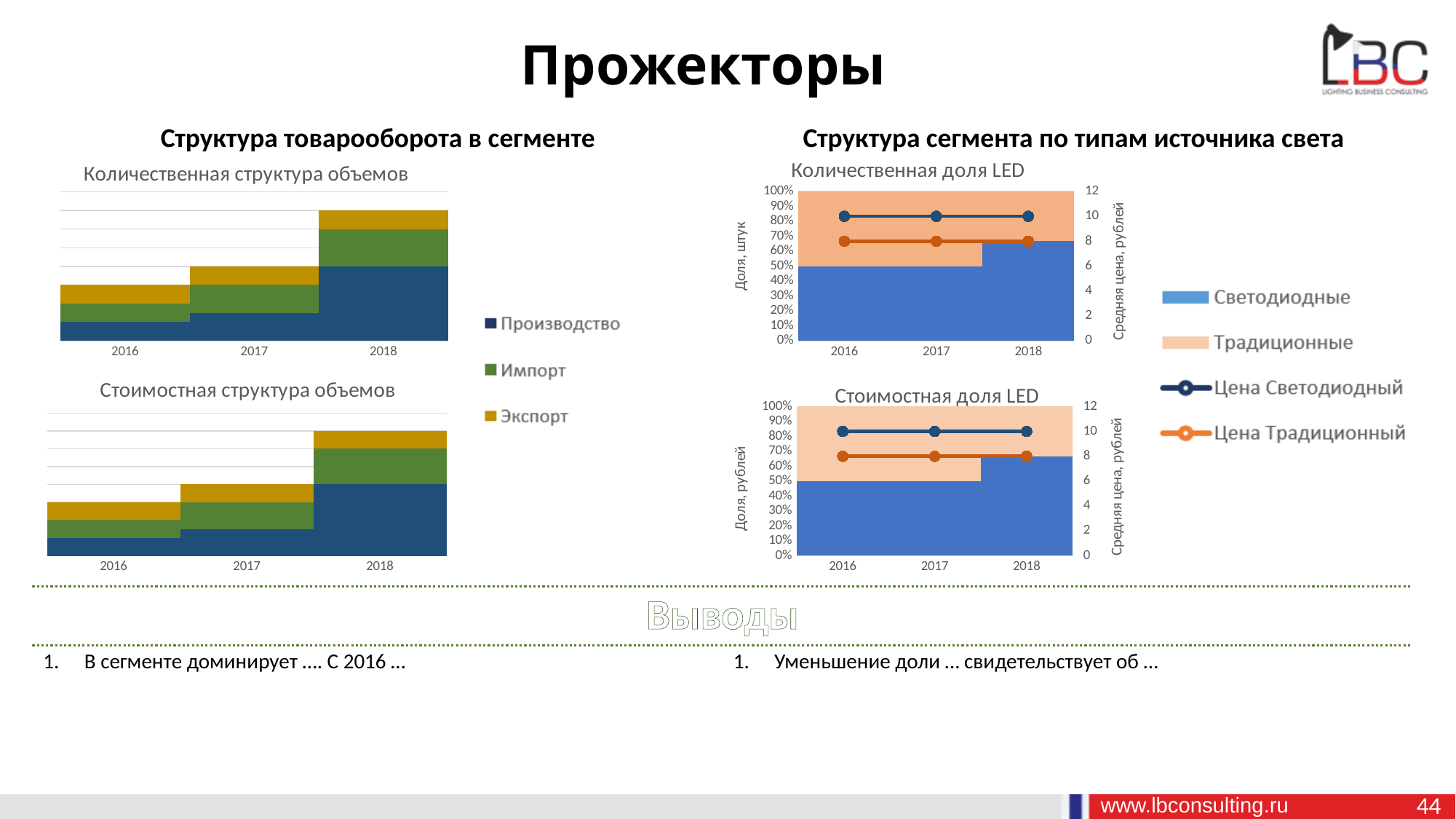
In the 'Стоимостная доля LED' chart, does the Светодиодные share rise or fall from 2016 to 2018? Rises How many series does the legend of the left-hand charts ('Структура товарооборота в сегменте') list? 3 In the 'Количественная доля LED' chart, which price line is higher: Цена Светодиодный or Цена Традиционный? Цена Светодиодный In the 'Количественная доля LED' chart, is the Светодиодные share for 2018 greater or less than 50%? greater In the 'Стоимостная доля LED' chart, is the Цена Традиционный value for 2017 greater or less than 6 on the right axis? greater How many series does the legend of the right-hand charts ('Структура сегмента по типам источника света') list? 4 What kind of chart is the 'Количественная структура объемов' chart on the left? Stacked bar chart In the 'Количественная структура объемов' chart, does the Производство segment rise or fall from 2016 to 2018? Rises How many years are shown on the x axis of the 'Стоимостная структура объемов' chart? 3 In the 'Количественная доля LED' chart, is the Светодиодные share for 2016 greater or less than 70%? less What is the title of the bottom-left chart on the slide? Стоимостная структура объемов In the 'Количественная структура объемов' chart, which year has the tallest stacked bar? 2018